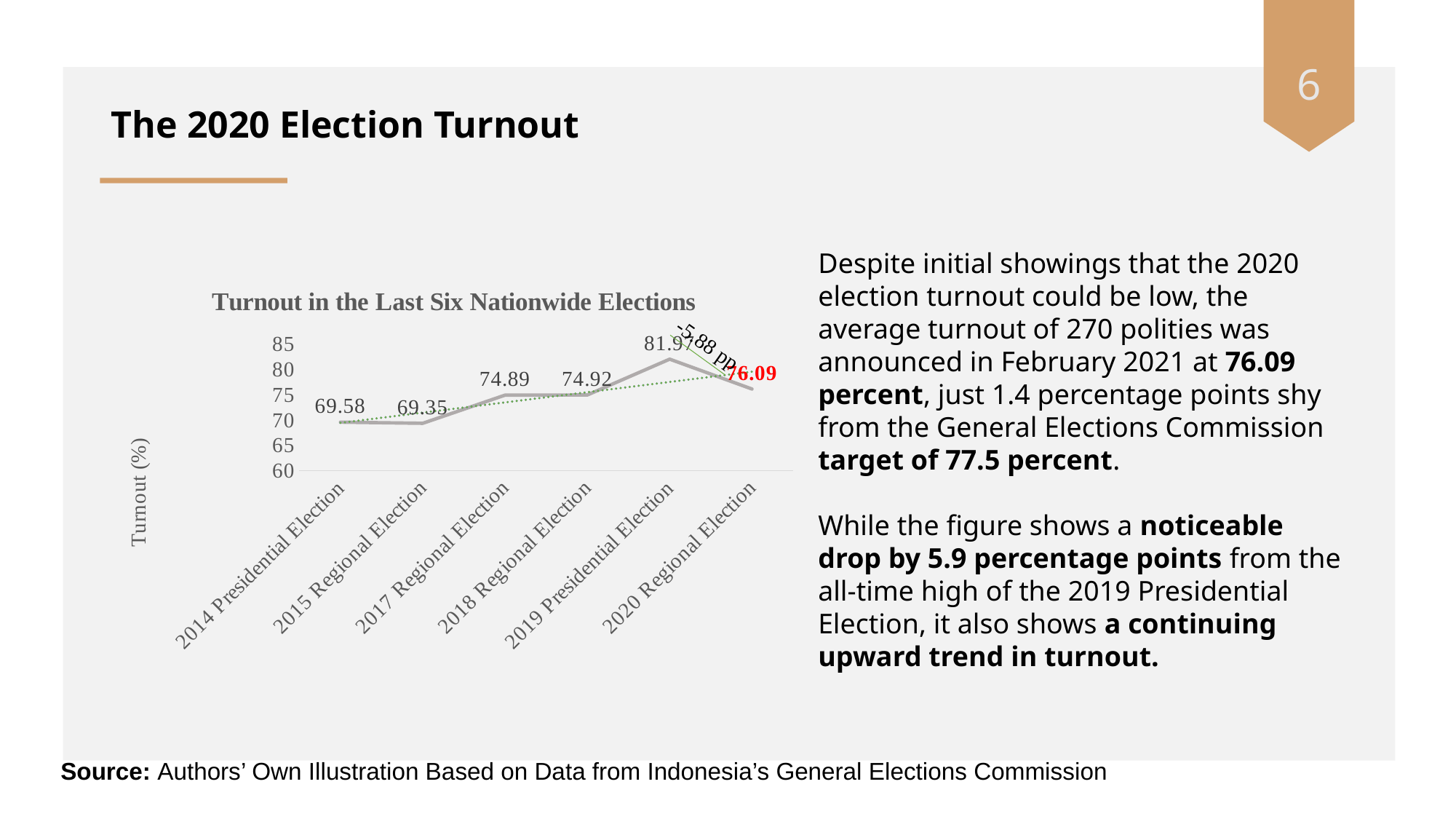
What is the turnout value for the 2015 Regional Election? 69.35 Which election has the lowest turnout in the chart? 2015 Regional Election How many elections are plotted in the chart? 6 What is the difference in turnout between the 2017 Regional Election and the 2014 Presidential Election? 5.31 What is the turnout value for the 2017 Regional Election? 74.89 Is the turnout for the 2019 Presidential Election greater or less than 80? greater What is the turnout value for the 2018 Regional Election? 74.92 What kind of chart is shown on the slide? line chart What is the title of the chart? Turnout in the Last Six Nationwide Elections Which election has the highest turnout in the chart? 2019 Presidential Election What is the turnout value for the 2020 Regional Election? 76.09 What is the turnout value for the 2014 Presidential Election? 69.58